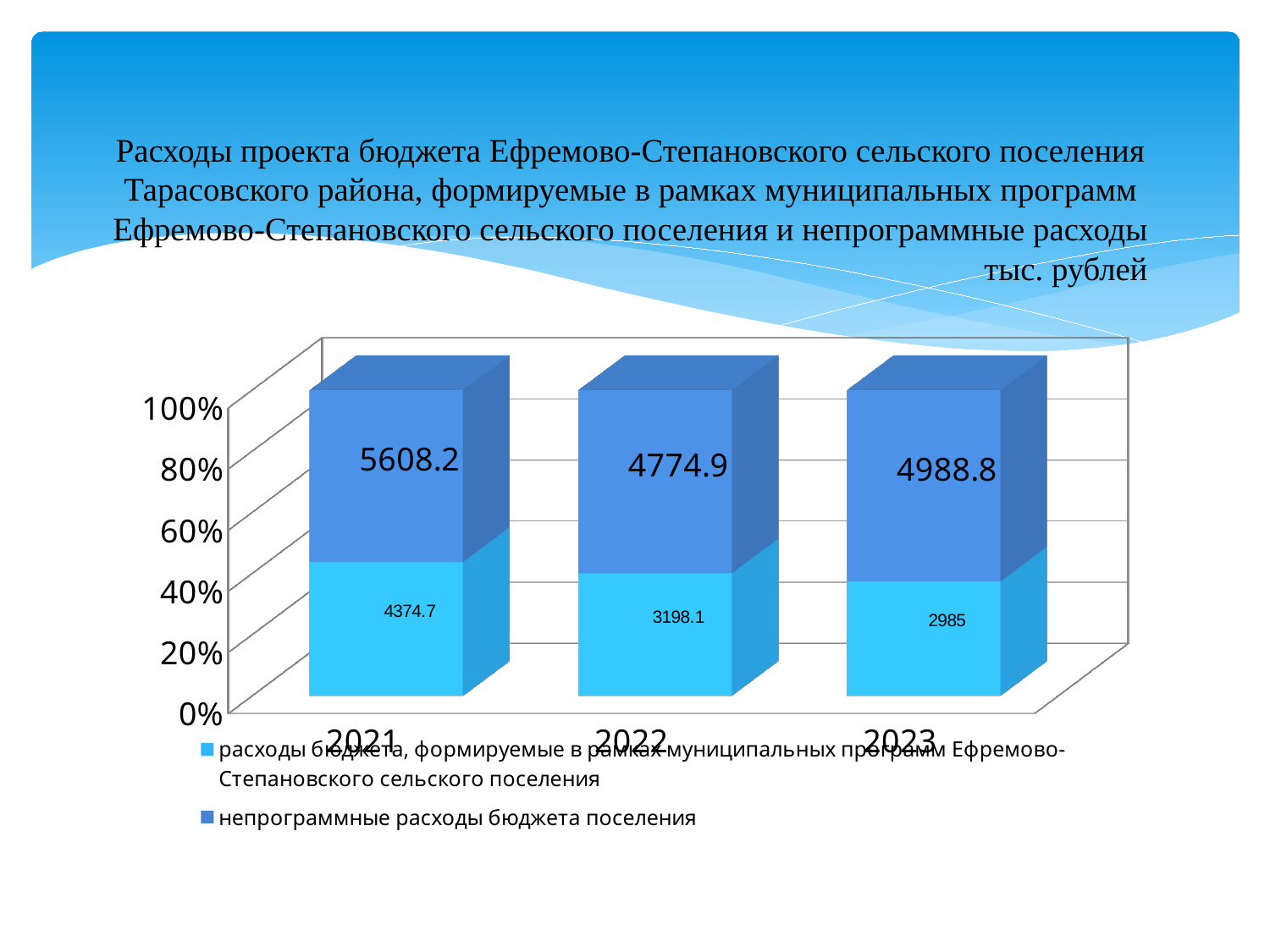
How many years are shown on the x axis of the chart? 3 What is the total of the two series for 2021? 9982.9 Which is larger in 2023: непрограммные расходы бюджета поселения or расходы в рамках муниципальных программ? непрограммные расходы бюджета поселения What is the difference between непрограммные расходы and программные расходы in 2021? 1233.5 What is the value of расходы бюджета, формируемые в рамках муниципальных программ for 2023? 2985 How many series does the legend list? 2 What kind of chart is shown on the slide? stacked bar chart In which year is the value of непрограммные расходы бюджета поселения the highest? 2021 What is the value of непрограммные расходы бюджета поселения for 2021? 5608.2 In which year is the value of расходы бюджета, формируемые в рамках муниципальных программ the lowest? 2023 What is the value of расходы бюджета, формируемые в рамках муниципальных программ for 2022? 3198.1 Do the values of расходы бюджета, формируемые в рамках муниципальных программ rise or fall from 2021 to 2023? fall